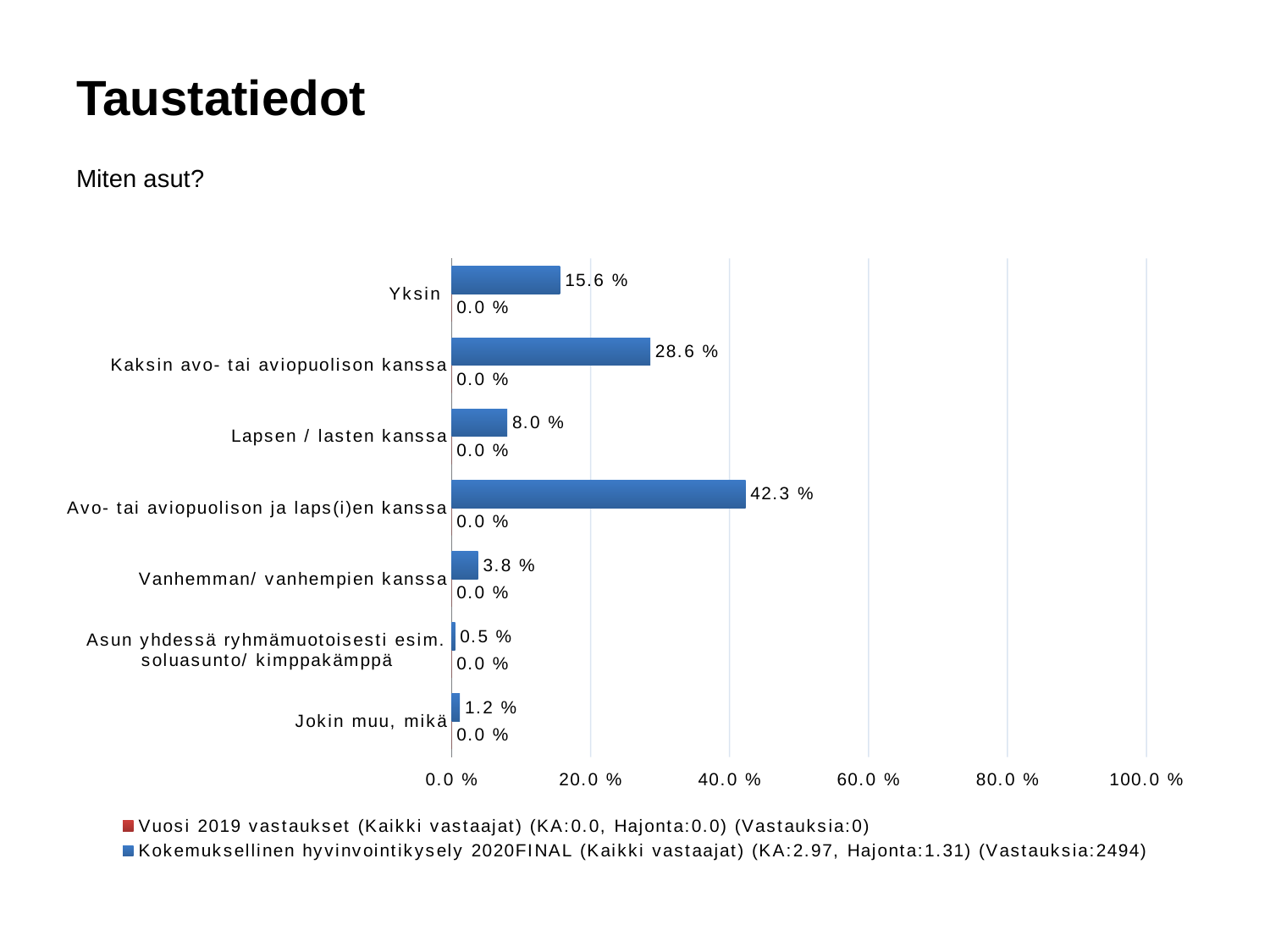
Which category has the highest value in the 2020FINAL series? Avo- tai aviopuolison ja laps(i)en kanssa In the 2020FINAL series, which is larger: "Vanhemman/ vanhempien kanssa" or "Jokin muu, mikä"? Vanhemman/ vanhempien kanssa How many series does the legend list? 2 How many categories are shown on the chart? 7 Is the 2020FINAL value for "Avo- tai aviopuolison ja laps(i)en kanssa" greater or less than 40.0 %? greater What is the value for "Yksin" in the Kokemuksellinen hyvinvointikysely 2020FINAL series? 15.6 % What kind of chart is shown on the slide? bar chart What is the value for "Avo- tai aviopuolison ja laps(i)en kanssa" in the 2020FINAL series? 42.3 % What is the value for "Lapsen / lasten kanssa" in the 2020FINAL series? 8.0 % What is the value for "Jokin muu, mikä" in the Vuosi 2019 vastaukset series? 0.0 % What is the difference between "Kaksin avo- tai aviopuolison kanssa" and "Yksin" in the 2020FINAL series? 13.0 % Which category has the lowest value in the 2020FINAL series? Asun yhdessä ryhmämuotoisesti esim. soluasunto/ kimppakämppä